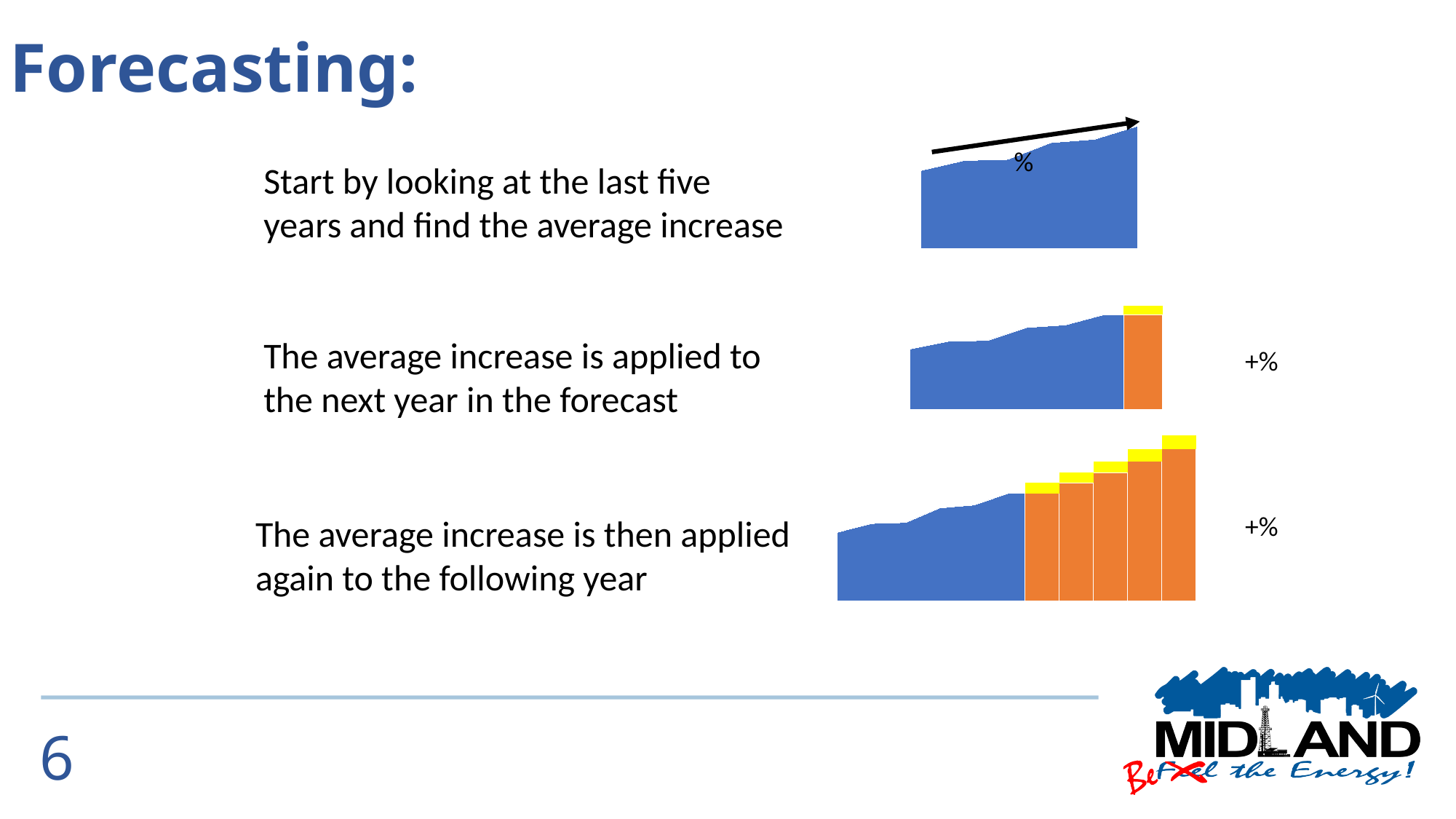
What colour marks the added average increase on top of the orange forecast bars? yellow In the middle chart, do the blue historical values rise or fall from left to right? rise In the bottom chart, is the rightmost orange bar taller or shorter than the leftmost orange bar? taller In the middle chart, how many orange forecast bars are shown? 1 In the bottom chart, how many orange forecast bars are shown? 5 How many charts are shown on the slide? 3 In the top chart, do the values rise or fall from left to right? rise In the bottom chart, do the orange forecast bars rise or fall from left to right? rise What colour is used for the historical data in all three charts? blue What kind of chart is the top chart on the slide? area chart